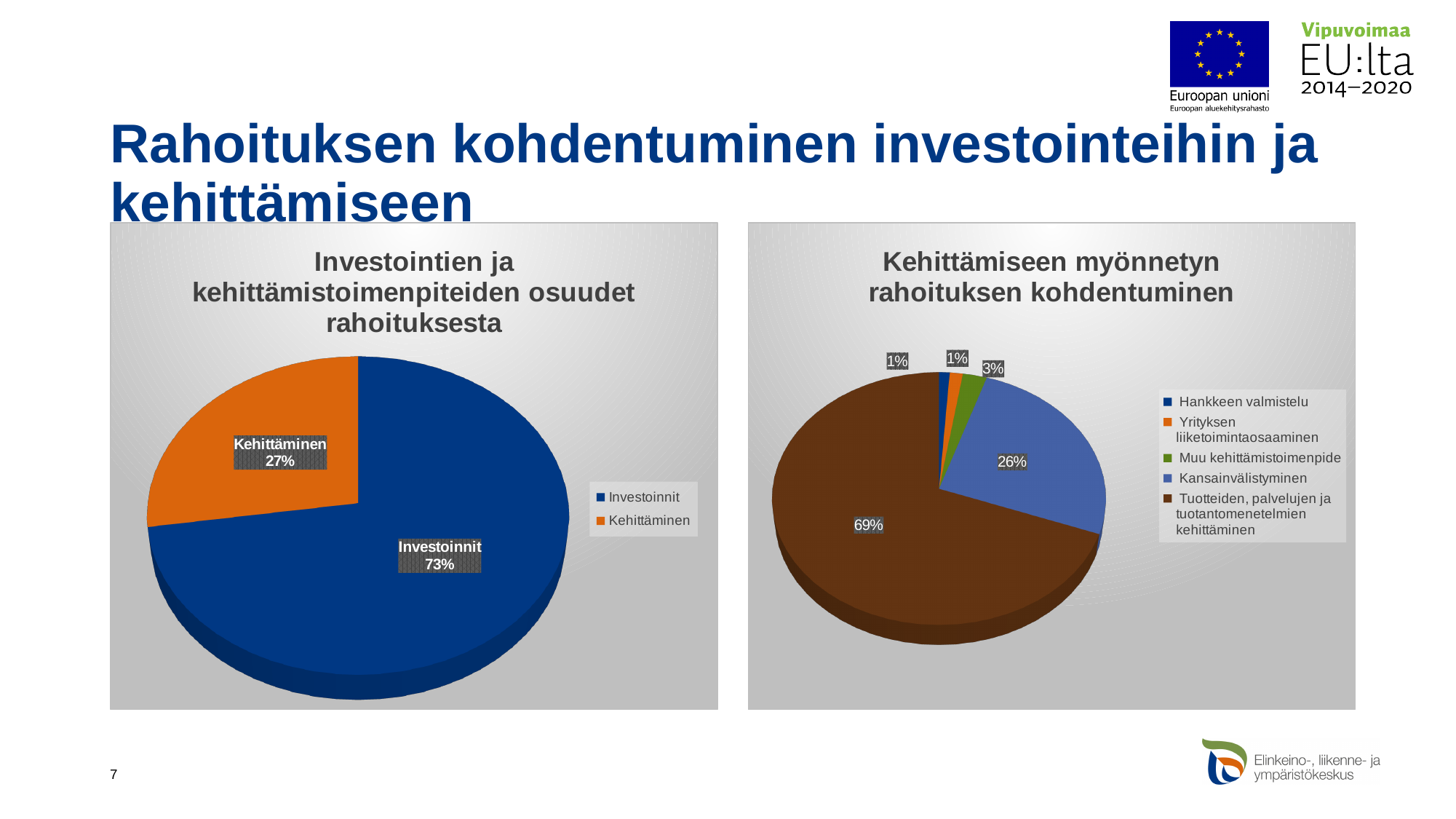
In the left chart, 'Investointien ja kehittämistoimenpiteiden osuudet rahoituksesta', what colour is the Kehittäminen slice? Orange In the left chart, 'Investointien ja kehittämistoimenpiteiden osuudet rahoituksesta', which slice is larger, Investoinnit or Kehittäminen? Investoinnit In the right chart, 'Kehittämiseen myönnetyn rahoituksen kohdentuminen', what share does Muu kehittämistoimenpide have? 3% In the left chart, 'Investointien ja kehittämistoimenpiteiden osuudet rahoituksesta', what share does Investoinnit have? 73% What kind of chart is the left chart, 'Investointien ja kehittämistoimenpiteiden osuudet rahoituksesta'? Pie chart In the right chart, 'Kehittämiseen myönnetyn rahoituksen kohdentuminen', which category has the largest share? Tuotteiden, palvelujen ja tuotantomenetelmien kehittäminen In the left chart, 'Investointien ja kehittämistoimenpiteiden osuudet rahoituksesta', what share does Kehittäminen have? 27% In the left chart, 'Investointien ja kehittämistoimenpiteiden osuudet rahoituksesta', what is the difference in percentage points between Investoinnit and Kehittäminen? 46 How many categories does the legend of the right chart, 'Kehittämiseen myönnetyn rahoituksen kohdentuminen', list? 5 In the right chart, 'Kehittämiseen myönnetyn rahoituksen kohdentuminen', what is the difference in percentage points between 'Tuotteiden, palvelujen ja tuotantomenetelmien kehittäminen' and Kansainvälistyminen? 43